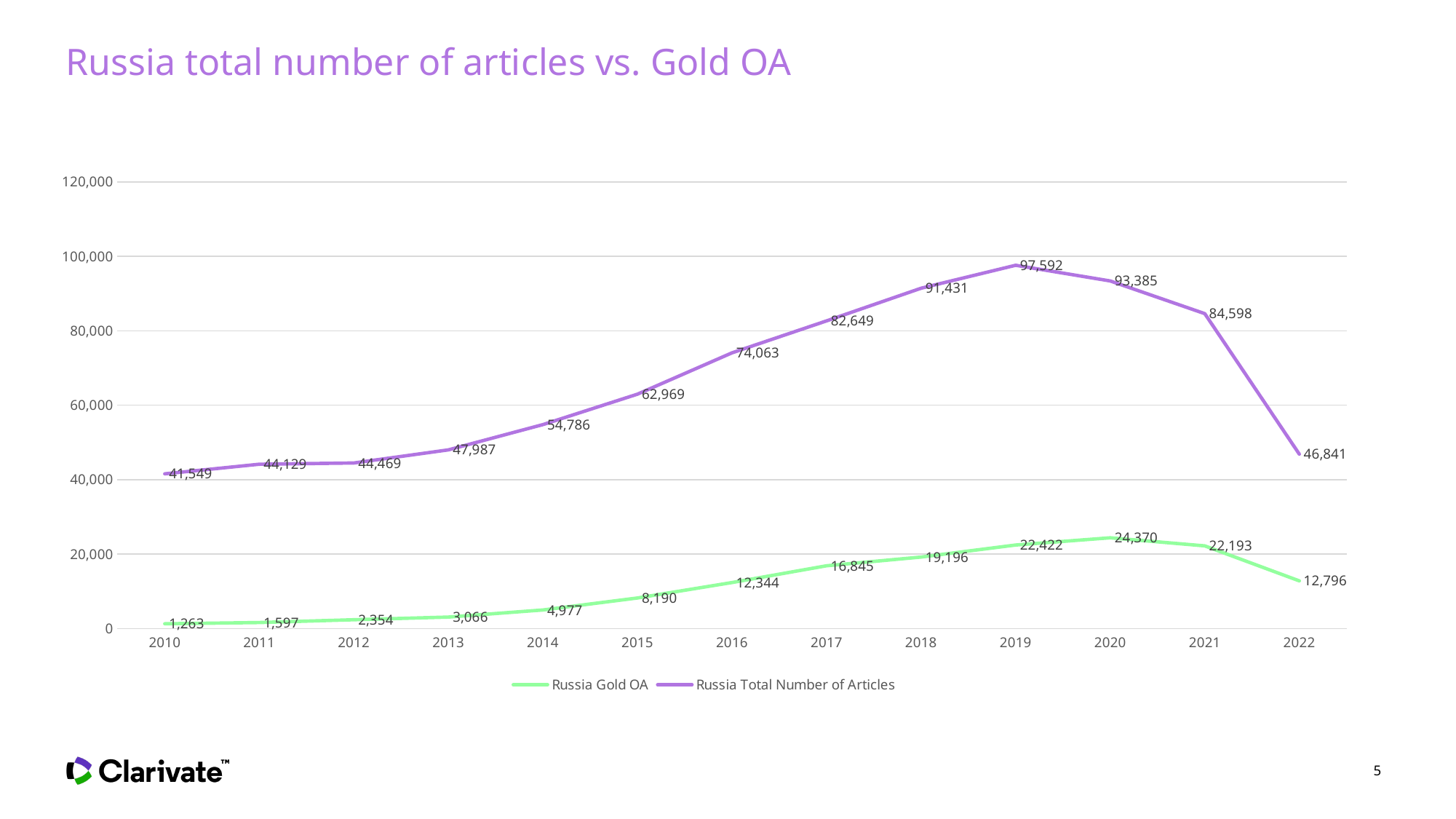
How many series does the legend list? 2 What is the value for Russia Gold OA in 2010? 1,263 In which year does Russia Total Number of Articles reach its highest value? 2019 What is the value for Russia Gold OA in 2020? 24,370 Which is larger: Russia Gold OA in 2021 or Russia Gold OA in 2022? Russia Gold OA in 2021 What is the value for Russia Total Number of Articles in 2022? 46,841 What is the difference between Russia Total Number of Articles and Russia Gold OA in 2022? 34,045 In which year is Russia Gold OA at its lowest? 2010 Is the value for Russia Total Number of Articles in 2016 greater or less than 60,000? greater How many years are shown on the x axis? 13 What is the value for Russia Total Number of Articles in 2019? 97,592 What kind of chart is shown on the slide? Line chart